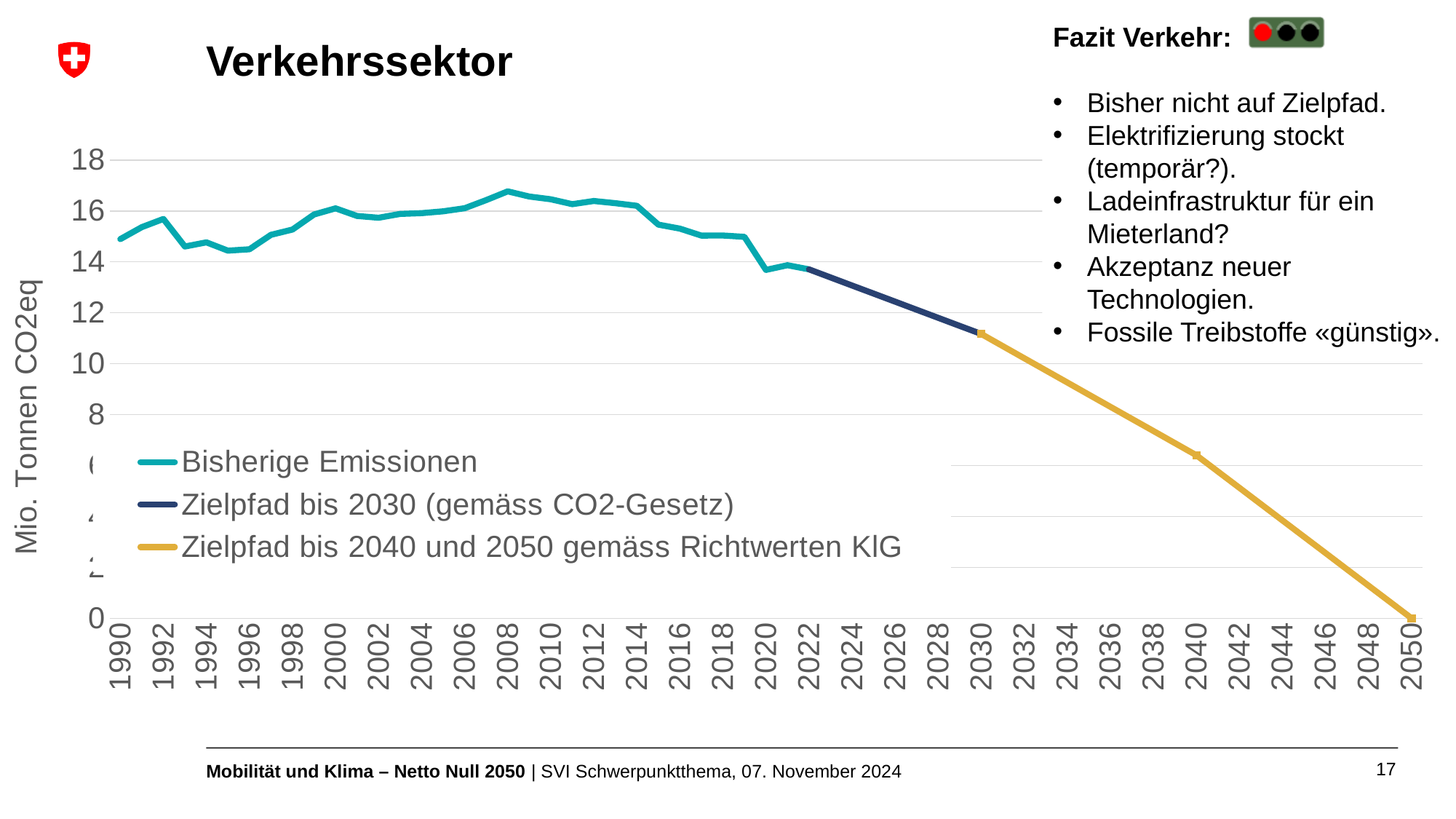
Is the value of the Zielpfad line in 2040 greater or less than 8? less What kind of chart is shown on the slide? line chart What is the label of the y axis? Mio. Tonnen CO2eq Which legend entry is drawn in yellow? Zielpfad bis 2040 und 2050 gemäss Richtwerten KlG What is the value of the Zielpfad line in 2050? 0 Is the value of the Zielpfad bis 2030 line in 2030 greater or less than 12? less Which is larger, the Bisherige Emissionen value in 2008 or in 2020? 2008 How many series does the chart legend list? 3 Is the value of Bisherige Emissionen in 2008 greater or less than 16? greater Do the values of the Zielpfad lines rise or fall from 2022 to 2050? fall In which year does the Bisherige Emissionen line reach its highest value? 2008